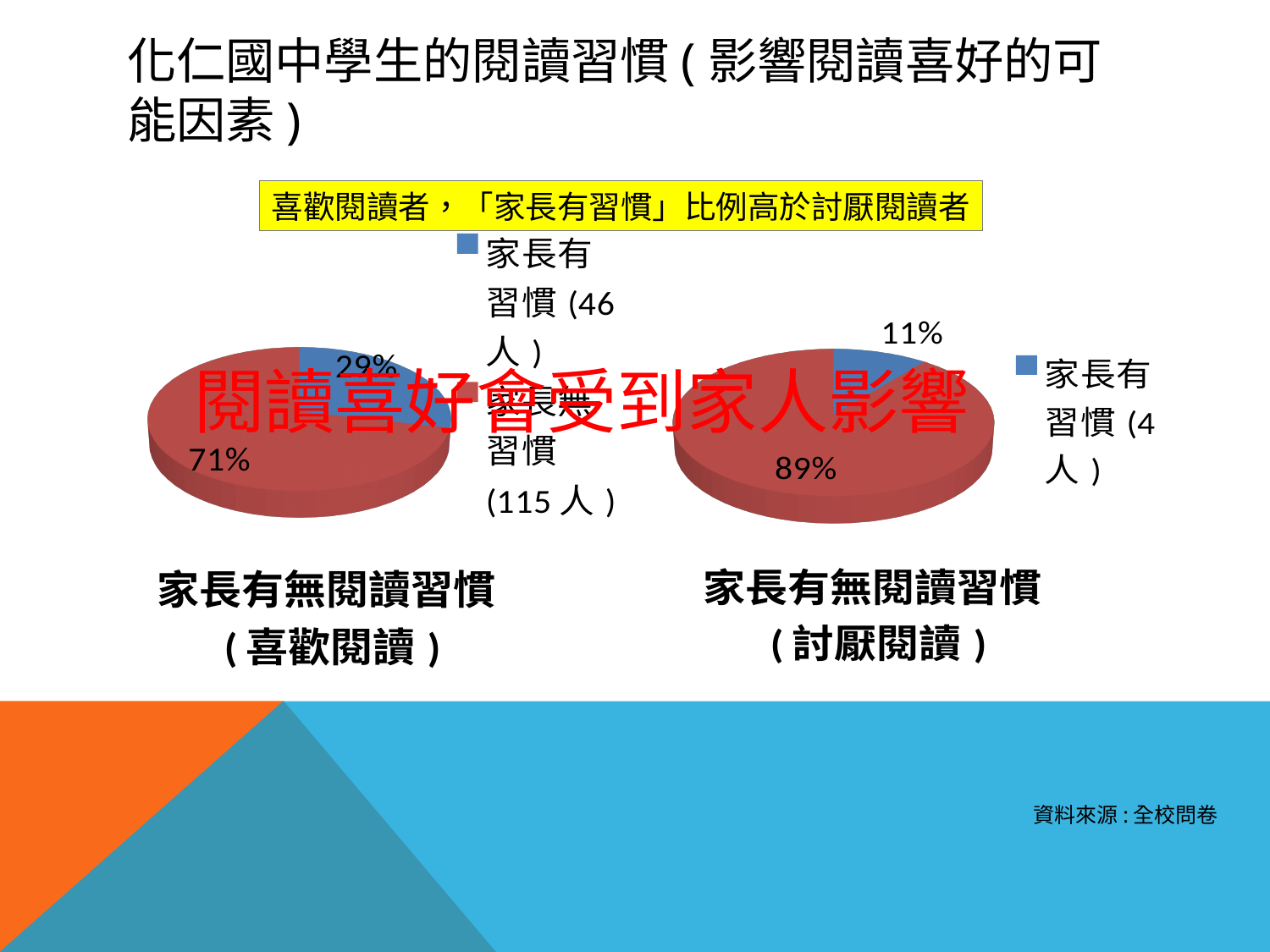
How many slices does each pie chart on the slide have? 2 In the right pie chart (家長有無閱讀習慣（討厭閱讀）), what percentage is shown for the blue slice, 家長有習慣? 11% In the left pie chart (喜歡閱讀), which slice is larger, the blue 家長有習慣 slice or the red slice? The red slice What is the difference between the 家長有習慣 percentage in the left chart (29%) and in the right chart (11%)? 18% In the right pie chart (家長有無閱讀習慣（討厭閱讀）), what percentage is shown for the red slice? 89% In the right pie chart (討厭閱讀), how many people are in the 家長有習慣 group according to the legend? 4 人 In the left pie chart (喜歡閱讀), how many people are in the 家長有習慣 group according to the legend? 46 人 Which chart has the larger 家長有習慣 share, the left chart (喜歡閱讀) or the right chart (討厭閱讀)? The left chart (喜歡閱讀) What kind of chart is used on this slide? Pie chart In the left pie chart (家長有無閱讀習慣（喜歡閱讀）), what percentage is shown for the blue slice, 家長有習慣? 29% In the left pie chart (家長有無閱讀習慣（喜歡閱讀）), what percentage is shown for the red slice? 71% What is the title shown below the right pie chart? 家長有無閱讀習慣（討厭閱讀）